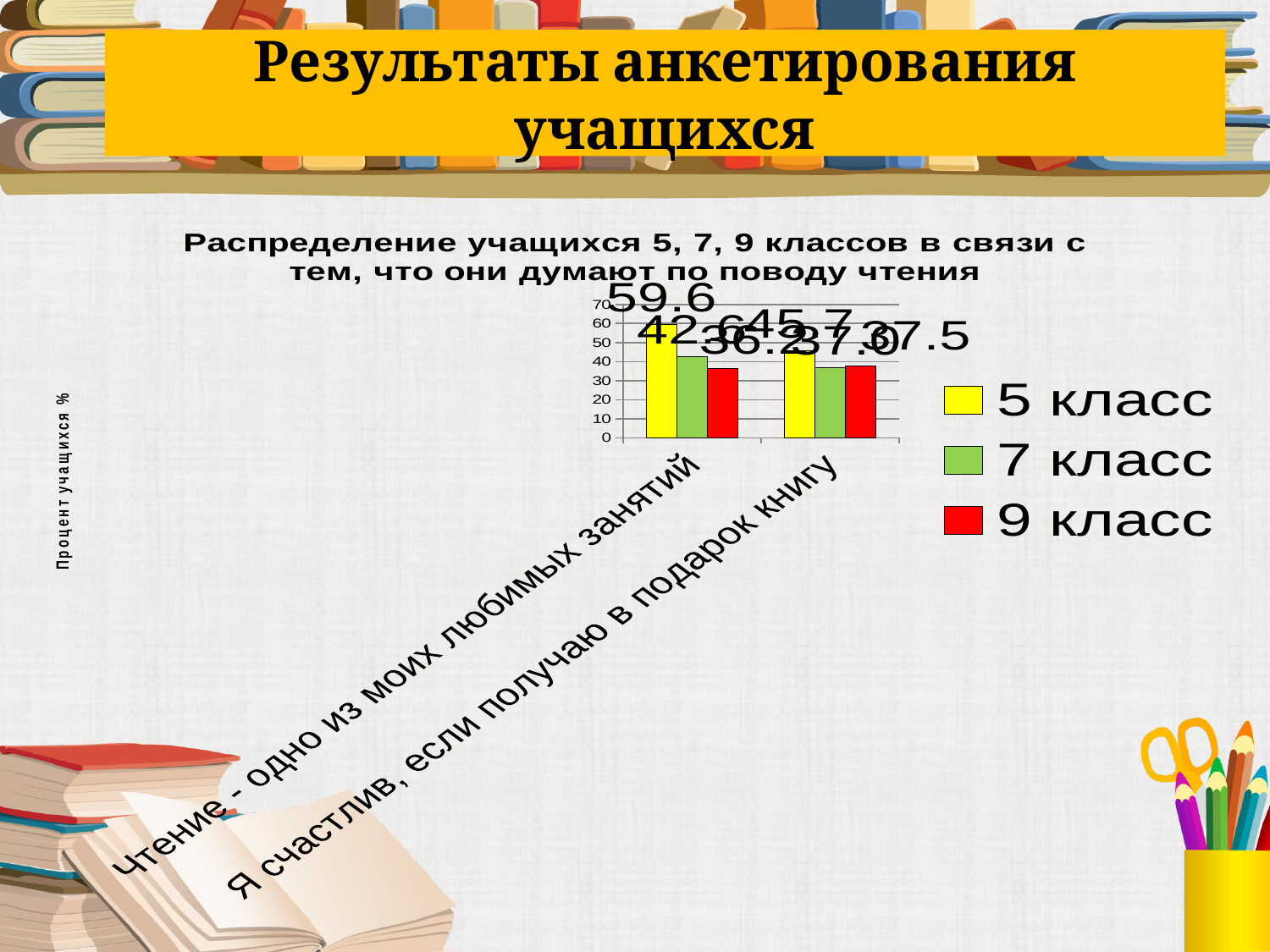
Is the value for 9 класс in the category "Чтение - одно из моих любимых занятий" greater or less than 40? less Is the value for 7 класс in the category "Я счастлив, если получаю в подарок книгу" greater or less than 40? less What is the value for 5 класс in the category "Я счастлив, если получаю в подарок книгу"? 45.7 Which series has the highest bar in the category "Чтение - одно из моих любимых занятий"? 5 класс What kind of chart is shown on the slide? bar chart What is the value for 5 класс in the category "Чтение - одно из моих любимых занятий"? 59.6 Which is larger for 5 класс: the value for "Чтение - одно из моих любимых занятий" or for "Я счастлив, если получаю в подарок книгу"? Чтение - одно из моих любимых занятий What is the difference between the 5 класс values for "Чтение - одно из моих любимых занятий" and "Я счастлив, если получаю в подарок книгу"? 13.9 How many categories are shown on the x axis? 2 How many series does the legend list? 3 What is the label of the vertical axis? Процент учащихся % Which colour represents 9 класс in the legend? red